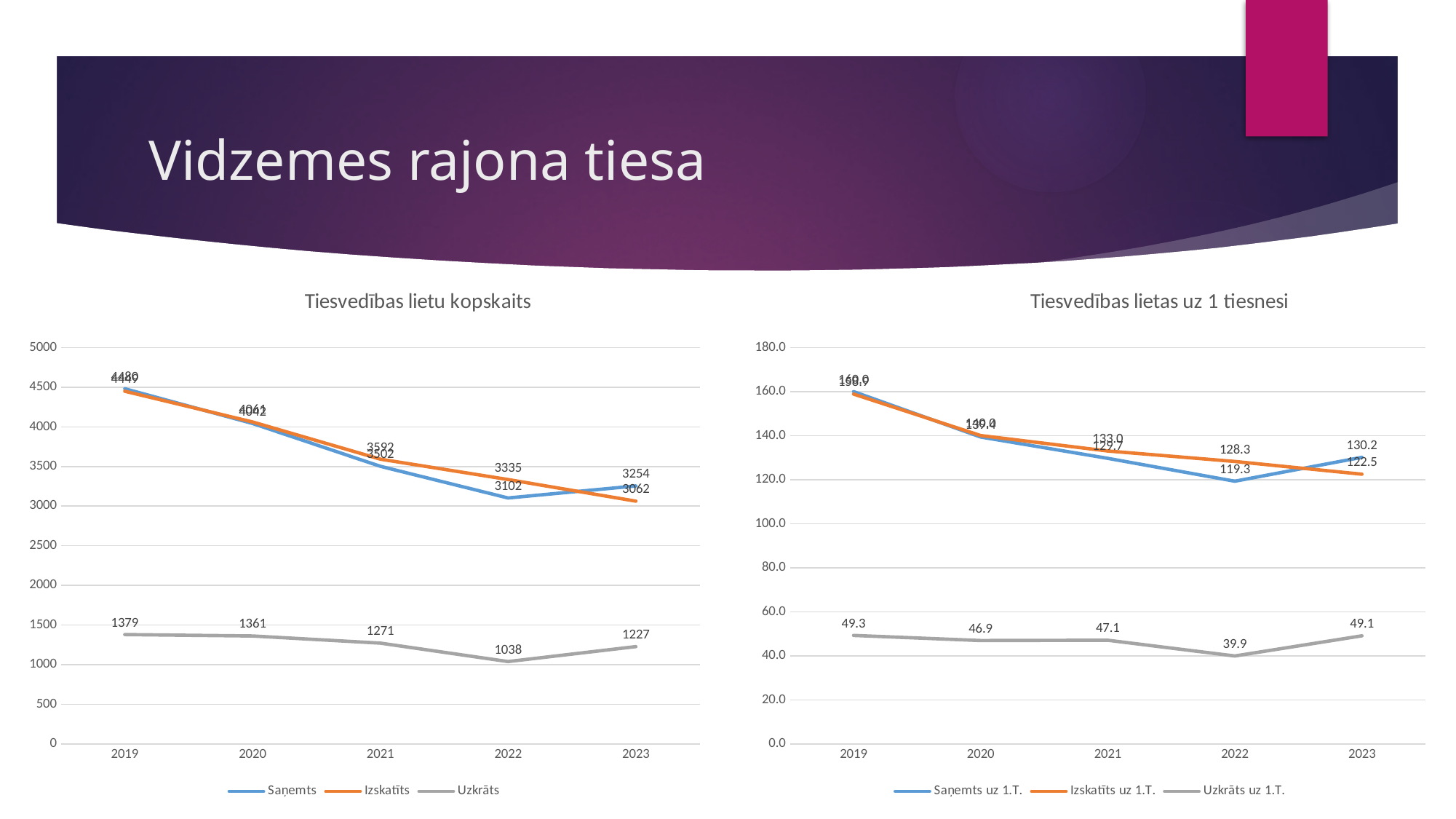
In the chart titled "Tiesvedības lietu kopskaits", what is the value of Izskatīts in 2021? 3592 In the chart titled "Tiesvedības lietu kopskaits", which is larger in 2023, Saņemts or Izskatīts? Saņemts In the chart titled "Tiesvedības lietu kopskaits", in which year is Uzkrāts lowest? 2022 In the chart titled "Tiesvedības lietas uz 1 tiesnesi", what is the difference between Izskatīts uz 1.T. and Saņemts uz 1.T. in 2021? 3.3 In the chart titled "Tiesvedības lietu kopskaits", what is the value of Saņemts in 2023? 3254 In the chart titled "Tiesvedības lietas uz 1 tiesnesi", how many years are shown on the x axis? 5 In the chart titled "Tiesvedības lietu kopskaits", what is the difference between Izskatīts and Saņemts in 2022? 233 In the chart titled "Tiesvedības lietu kopskaits", how many series does the legend list? 3 In the chart titled "Tiesvedības lietas uz 1 tiesnesi", what is the value of Saņemts uz 1.T. in 2022? 119.3 In the chart titled "Tiesvedības lietas uz 1 tiesnesi", what is the value of Uzkrāts uz 1.T. in 2023? 49.1 What kind of chart is "Tiesvedības lietas uz 1 tiesnesi"? Line chart In the chart titled "Tiesvedības lietu kopskaits", what is the value of Uzkrāts in 2022? 1038